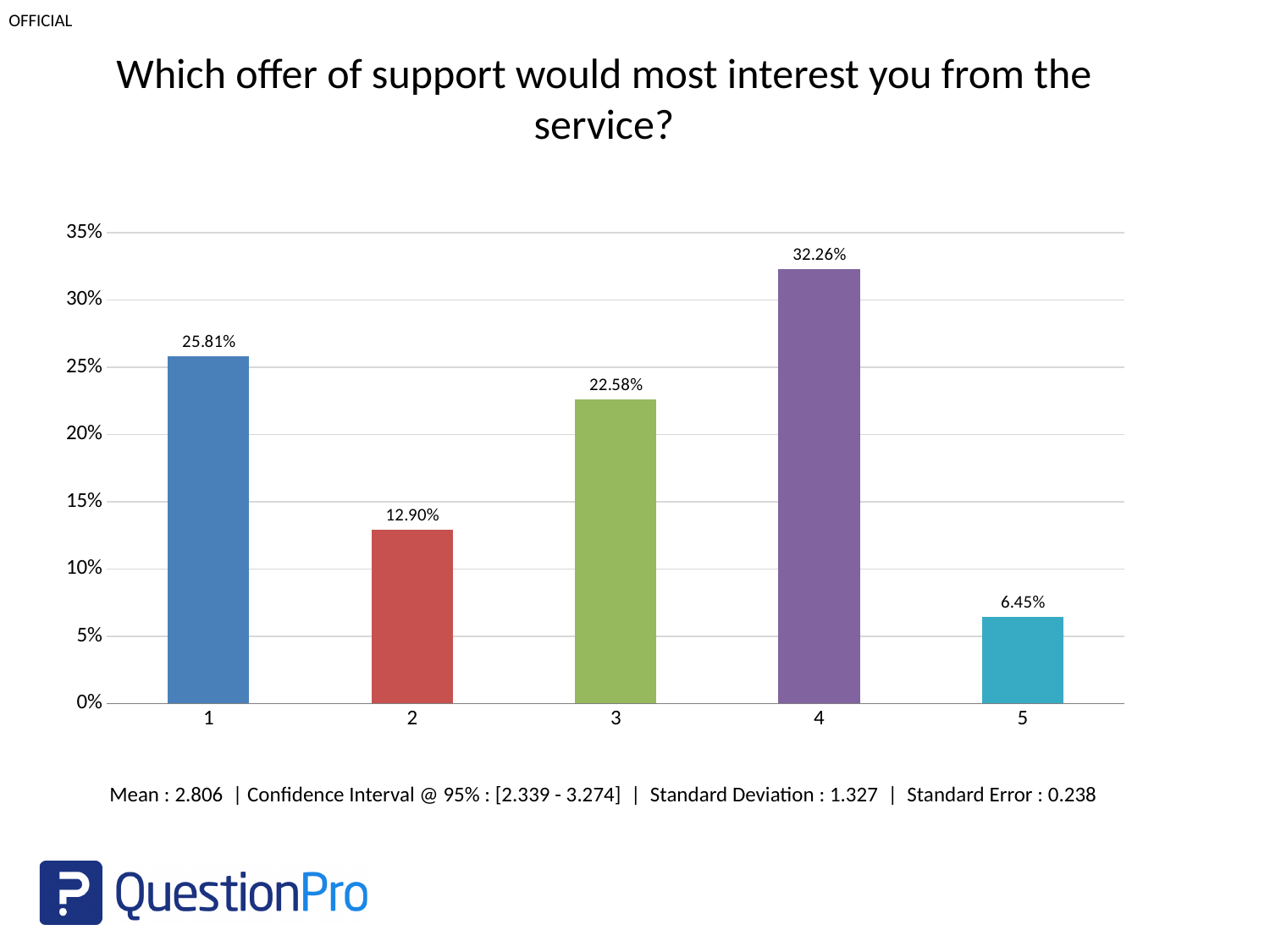
What is the value for category 1? 25.81% What is the value for category 5? 6.45% What is the value for category 4? 32.26% Is the value for category 2 greater or less than 15%? less What is the title of the chart? Which offer of support would most interest you from the service? Which category has the lowest value? 5 Which category has the highest value? 4 What kind of chart is shown on the slide? bar chart How many categories are shown on the x axis? 5 What is the difference between the values for category 4 and category 1? 6.45% What is the difference between the values for category 3 and category 2? 9.68% Which is larger, the value for category 1 or the value for category 3? category 1